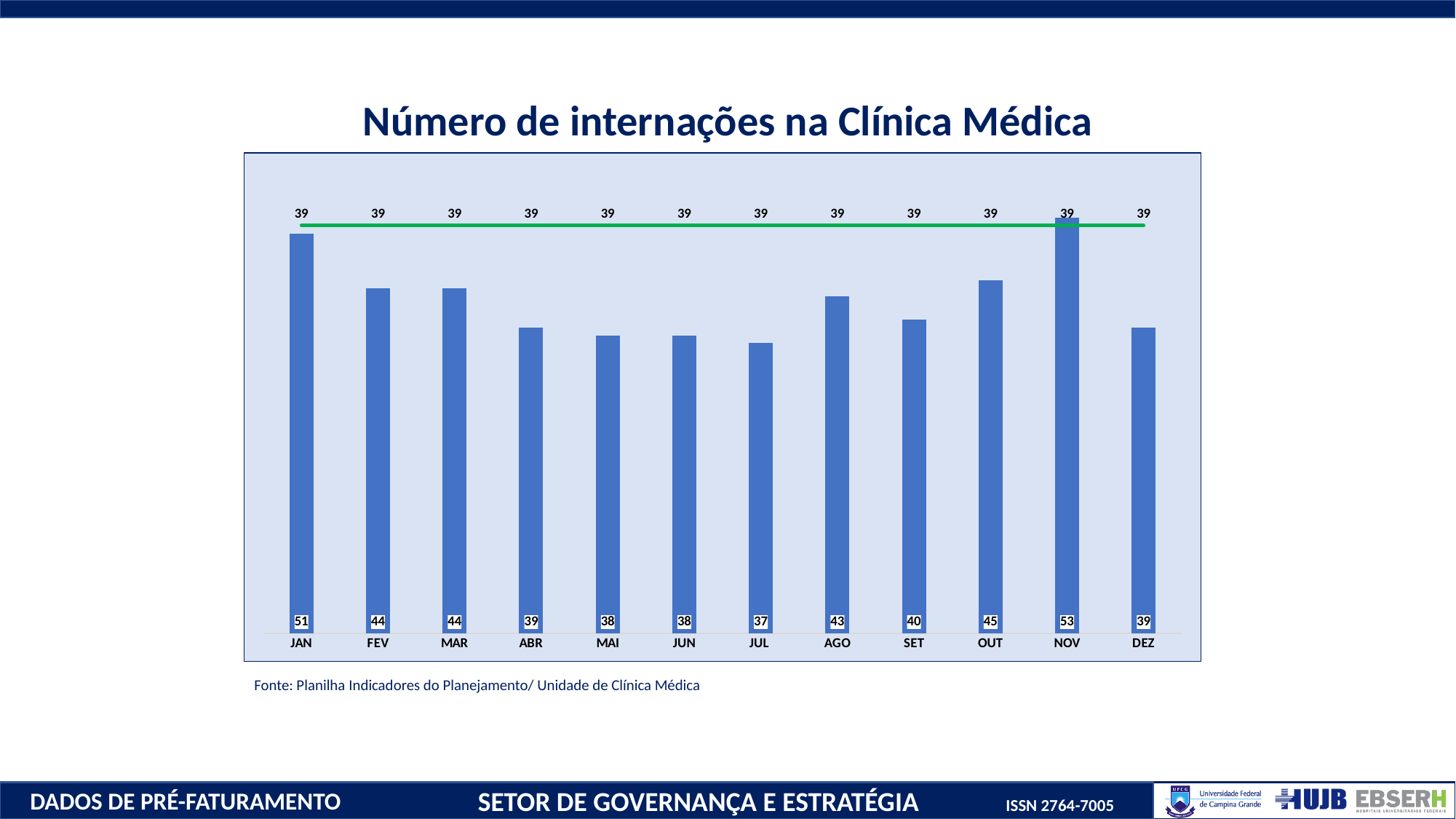
Which month has the highest number of internações? NOV What kind of chart is this? Bar chart What is the title of the chart? Número de internações na Clínica Médica What is the value shown for JUL? 37 What is the value shown for NOV? 53 Which is larger, the value for OUT or the value for AGO? OUT What is the number of internações for JAN? 51 What is the difference between the values for JAN and DEZ? 12 What is the difference between the values for NOV and JUL? 16 What constant value does the green line show across all months? 39 How many months are shown on the x axis? 12 Which month has the lowest number of internações? JUL